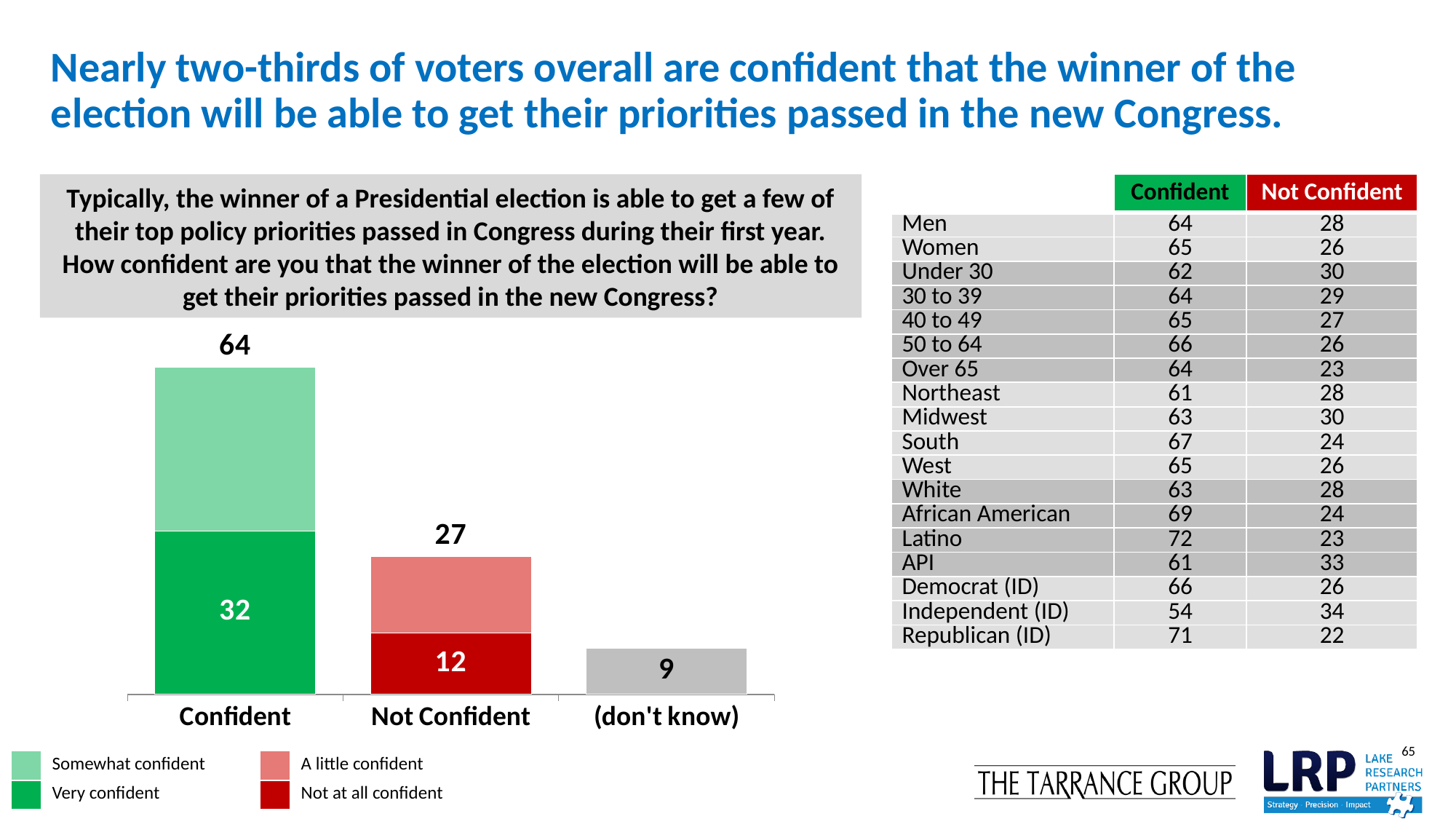
Which category has the lowest value? (don't know) What is the value for the (don't know) bar? 9 How many categories are shown on the x axis of the bar chart? 3 What is the value of the Not at all confident segment in the Not Confident bar? 12 Which is larger, the Not Confident total or the (don't know) value? Not Confident What kind of chart is shown on the slide? Stacked bar chart How many entries does the chart legend list? 4 What is the total value shown for the Confident bar? 64 Which category has the highest total value? Confident What is the difference between the Confident total and the Not Confident total? 37 What is the value of the Very confident segment in the Confident bar? 32 What is the total value shown for the Not Confident bar? 27